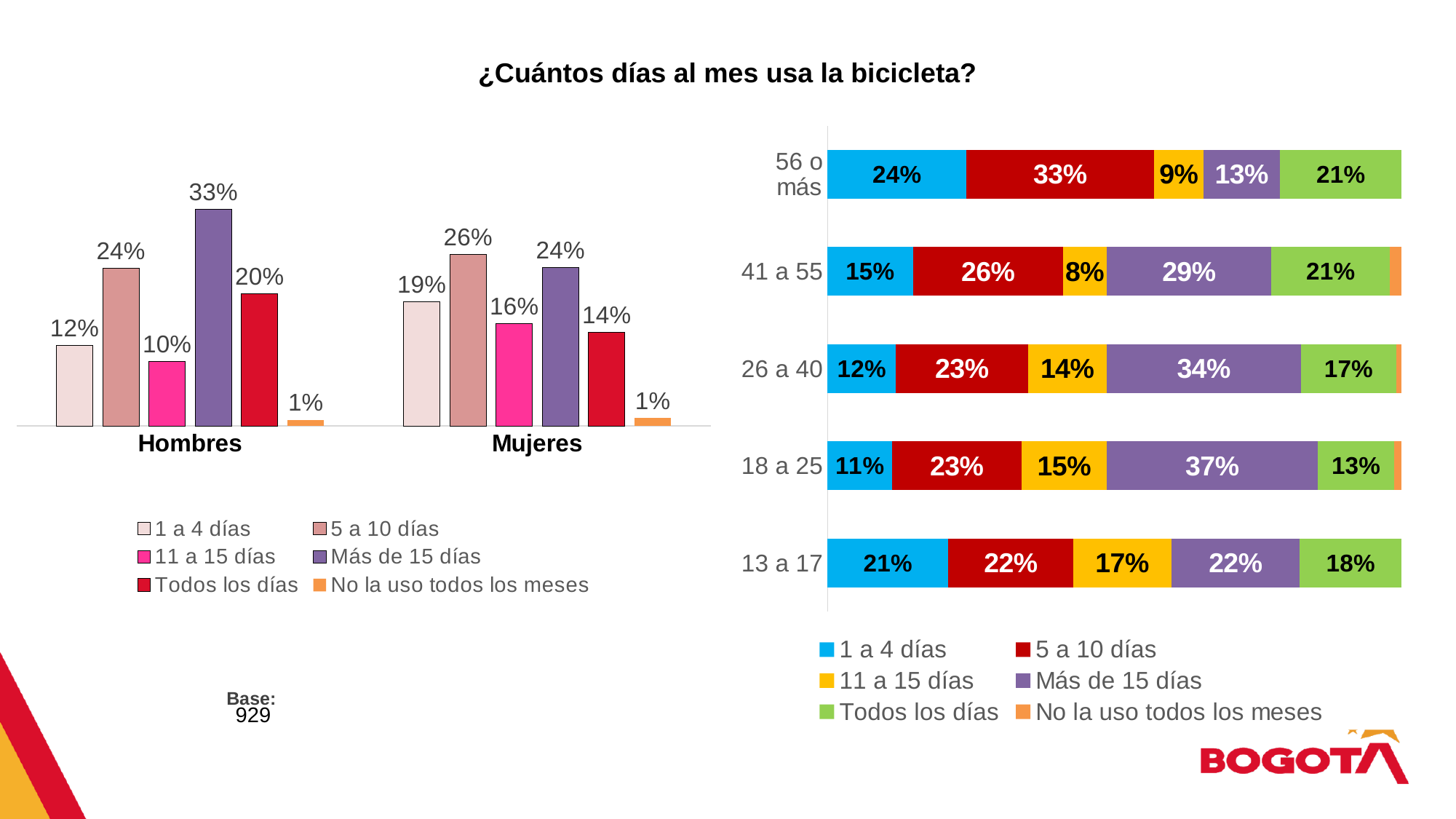
In the left chart (Hombres/Mujeres), what is the difference between the 'Todos los días' values for Hombres and Mujeres? 6% In the left chart (Hombres/Mujeres), what is the value for 'Más de 15 días' among Hombres? 33% In the right chart (age groups), what is the value for '5 a 10 días' in the '56 o más' group? 33% In the left chart (Hombres/Mujeres), which series has the highest value for Mujeres? 5 a 10 días In the right chart (age groups), how many age groups are shown? 5 In the right chart (age groups), what is the value for 'Más de 15 días' in the '18 a 25' group? 37% In the left chart (Hombres/Mujeres), what is the value for '1 a 4 días' among Mujeres? 19% In the right chart (age groups), what is the total of the labelled segments for the '13 a 17' bar? 100% In the right chart (age groups), which age group has the highest value for 'Más de 15 días'? 18 a 25 In the left chart (Hombres/Mujeres), how many series does the legend list? 6 What kind of chart is the chart on the right, with age groups? Stacked bar chart In the left chart (Hombres/Mujeres), which is larger: '11 a 15 días' for Hombres or for Mujeres? Mujeres